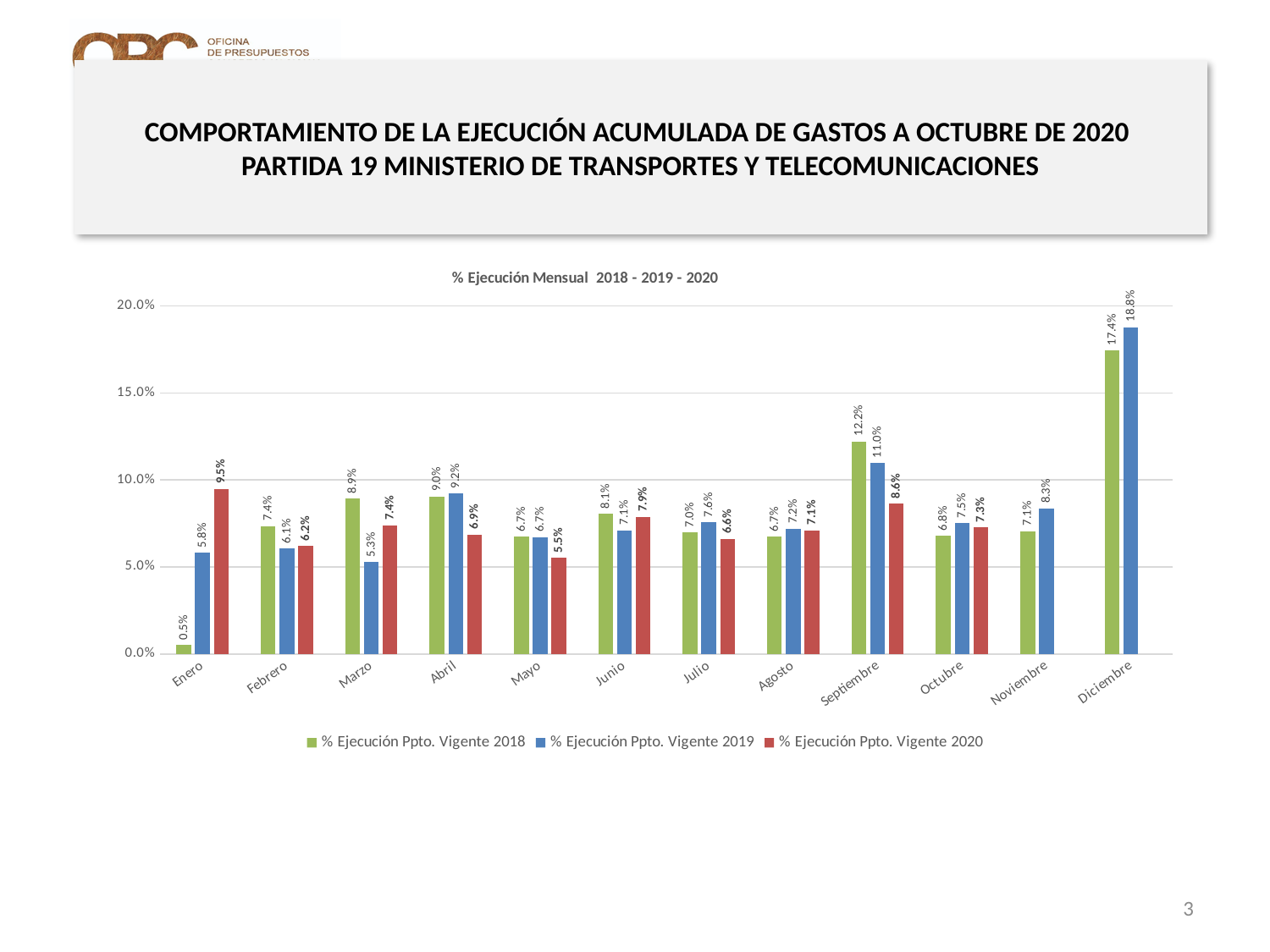
Which is larger for Marzo: the 2018 value or the 2019 value? 2018 value What is the value for Diciembre in the % Ejecución Ppto. Vigente 2019 series? 18.8% What is the value for Septiembre in the % Ejecución Ppto. Vigente 2018 series? 12.2% What kind of chart is shown on the slide? Bar chart Is the value for Septiembre in the 2019 series greater or less than 10.0%? greater How many months are shown on the x axis? 12 What is the difference between the 2019 and 2018 values for Diciembre? 1.4% How many series does the legend list? 3 Which month has the lowest value in the % Ejecución Ppto. Vigente 2018 series? Enero What is the value for Enero in the % Ejecución Ppto. Vigente 2020 series? 9.5% Which month has the highest value in the % Ejecución Ppto. Vigente 2020 series? Enero What is the title of the chart? % Ejecución Mensual 2018 - 2019 - 2020